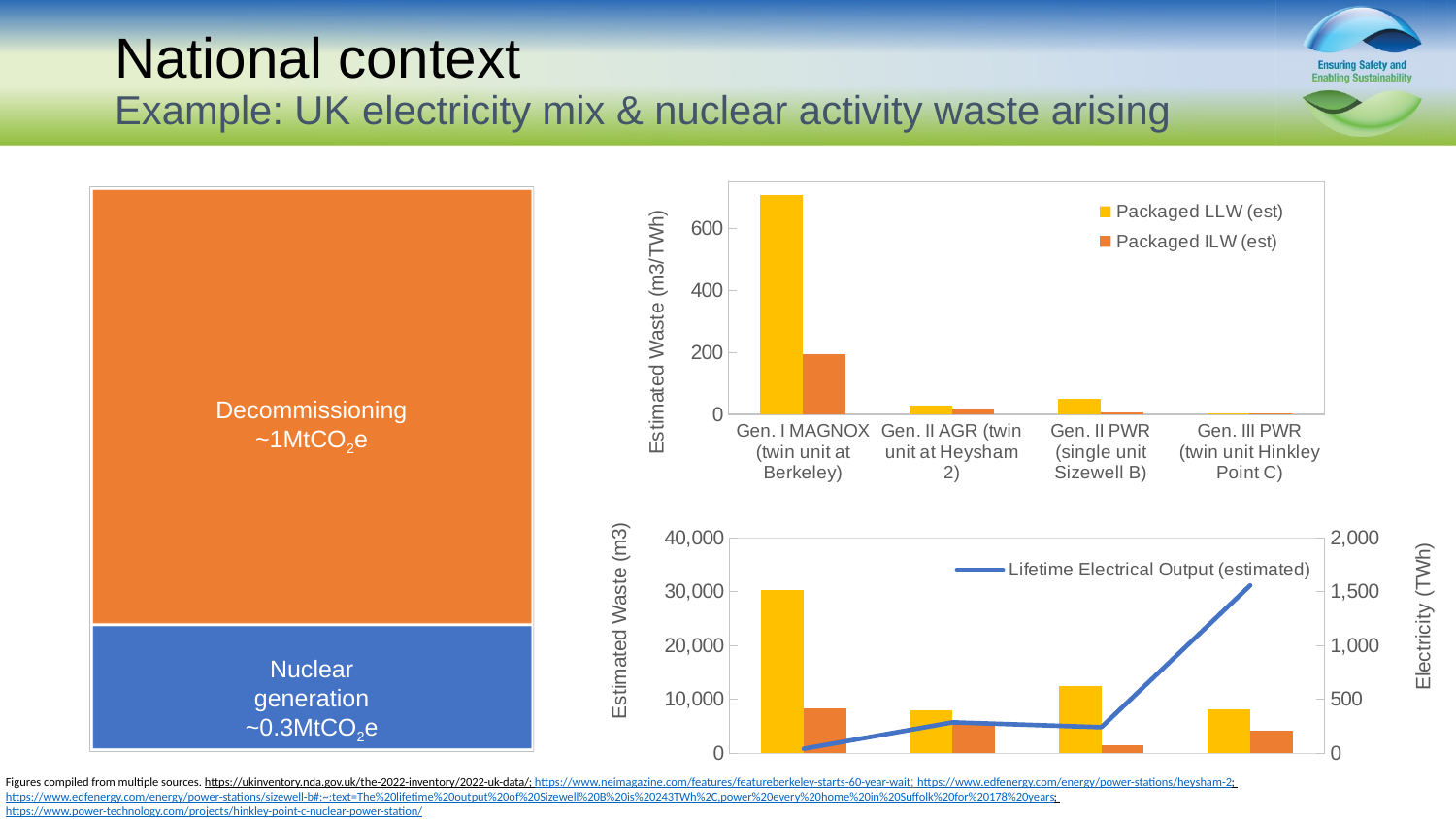
How many series does the legend of the top chart list? 2 In the top chart, which category has the highest Packaged LLW (est) value? Gen. I MAGNOX (twin unit at Berkeley) In the bottom chart, what series does the legend list? Lifetime Electrical Output (estimated) What kind of chart is the top chart on the right of the slide? bar chart In the top chart, is the Packaged ILW (est) value for Gen. I MAGNOX greater or less than 400? less What is the y-axis title of the top chart? Estimated Waste (m3/TWh) How many reactor categories are shown on the x axis of the top chart? 4 In the bottom chart, does the Lifetime Electrical Output (estimated) line rise or fall from Gen. II PWR (Sizewell B) to Gen. III PWR (Hinkley Point C)? rise In the bottom chart, is the yellow bar for Gen. I MAGNOX greater or less than 20,000? greater In the bottom chart, is the Lifetime Electrical Output (estimated) for Gen. III PWR (Hinkley Point C) greater or less than 1,000 TWh? greater In the top chart, which is larger for Gen. I MAGNOX: Packaged LLW (est) or Packaged ILW (est)? Packaged LLW (est)